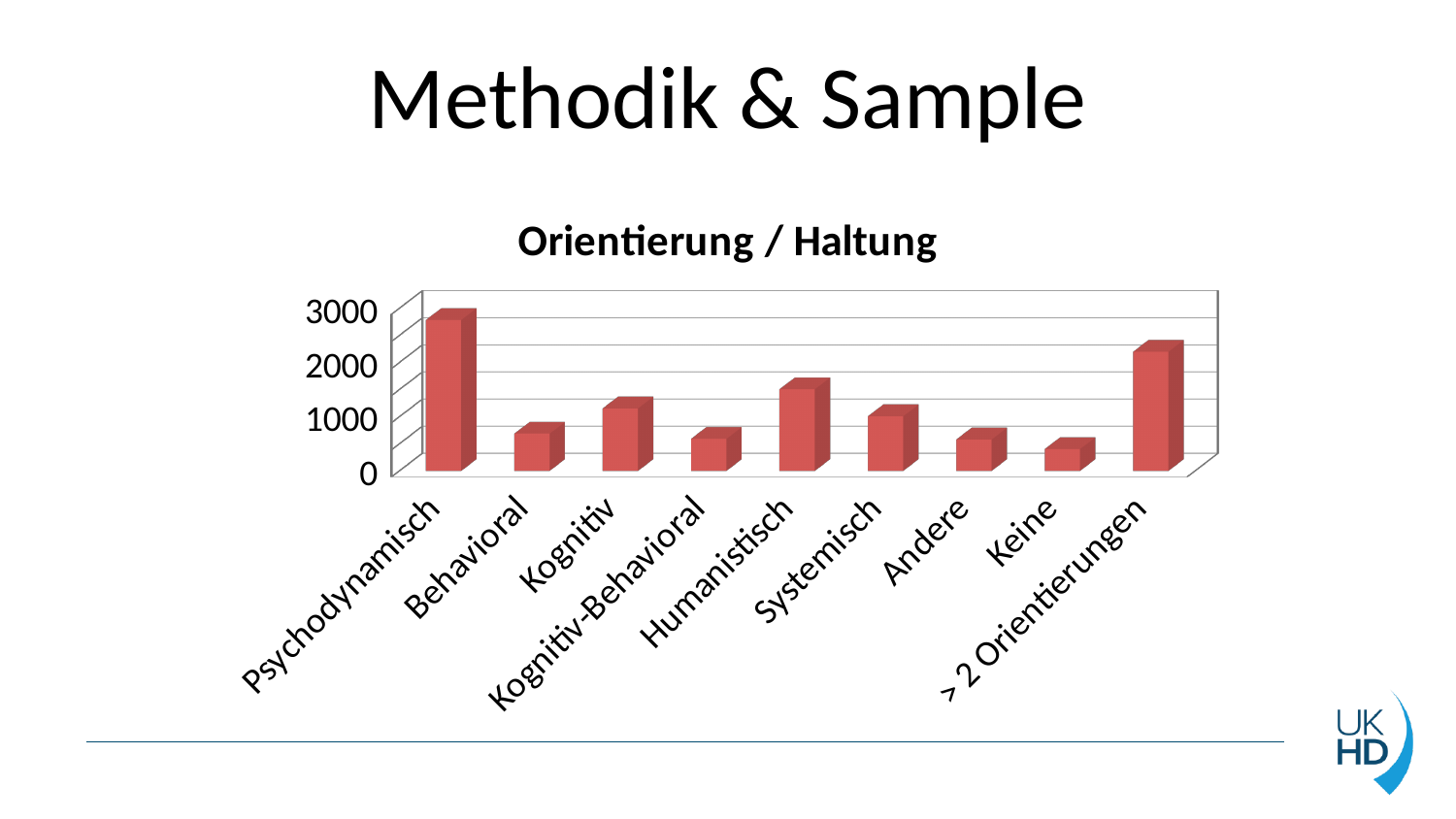
Which is larger, the value for Humanistisch or the value for Kognitiv? Humanistisch What is the title of the chart on the slide? Orientierung / Haltung Is the value for > 2 Orientierungen greater or less than 2000? greater Which category has the lowest bar in the chart? Keine Which is larger, the value for Psychodynamisch or the value for > 2 Orientierungen? Psychodynamisch Which category has the highest bar in the chart? Psychodynamisch What type of chart is shown under the title "Orientierung / Haltung"? bar chart Is the value for Behavioral greater or less than 1000? less Is the value for Psychodynamisch greater or less than 2000? greater How many categories are shown on the x axis of the chart? 9